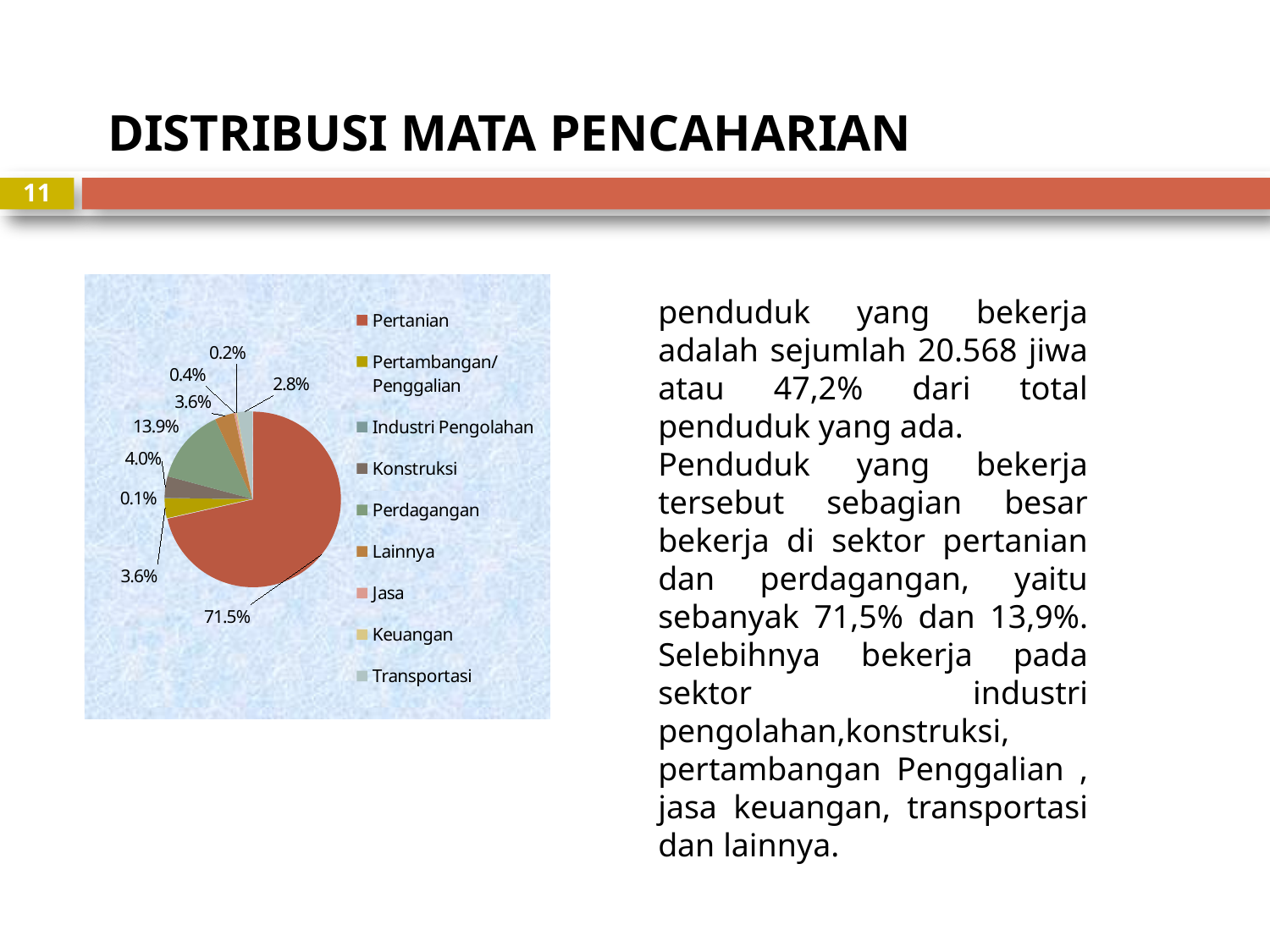
What is the smallest percentage label shown on the pie chart? 0.1% How many categories does the legend of the pie chart list? 9 What percentage is shown for Konstruksi? 4.0% What percentage of the pie does Perdagangan account for? 13.9% What type of chart is shown on the slide? Pie chart What is the title of the slide containing the pie chart? DISTRIBUSI MATA PENCAHARIAN Which category has the largest share of the pie? Pertanian What is the difference in percentage points between Pertanian and Perdagangan? 57.6 percentage points What percentage is shown for Transportasi? 2.8% What percentage of the pie does Pertanian account for? 71.5% What colour is the Pertanian slice in the pie chart? Red Which is larger, the share for Pertanian or the share for Perdagangan? Pertanian